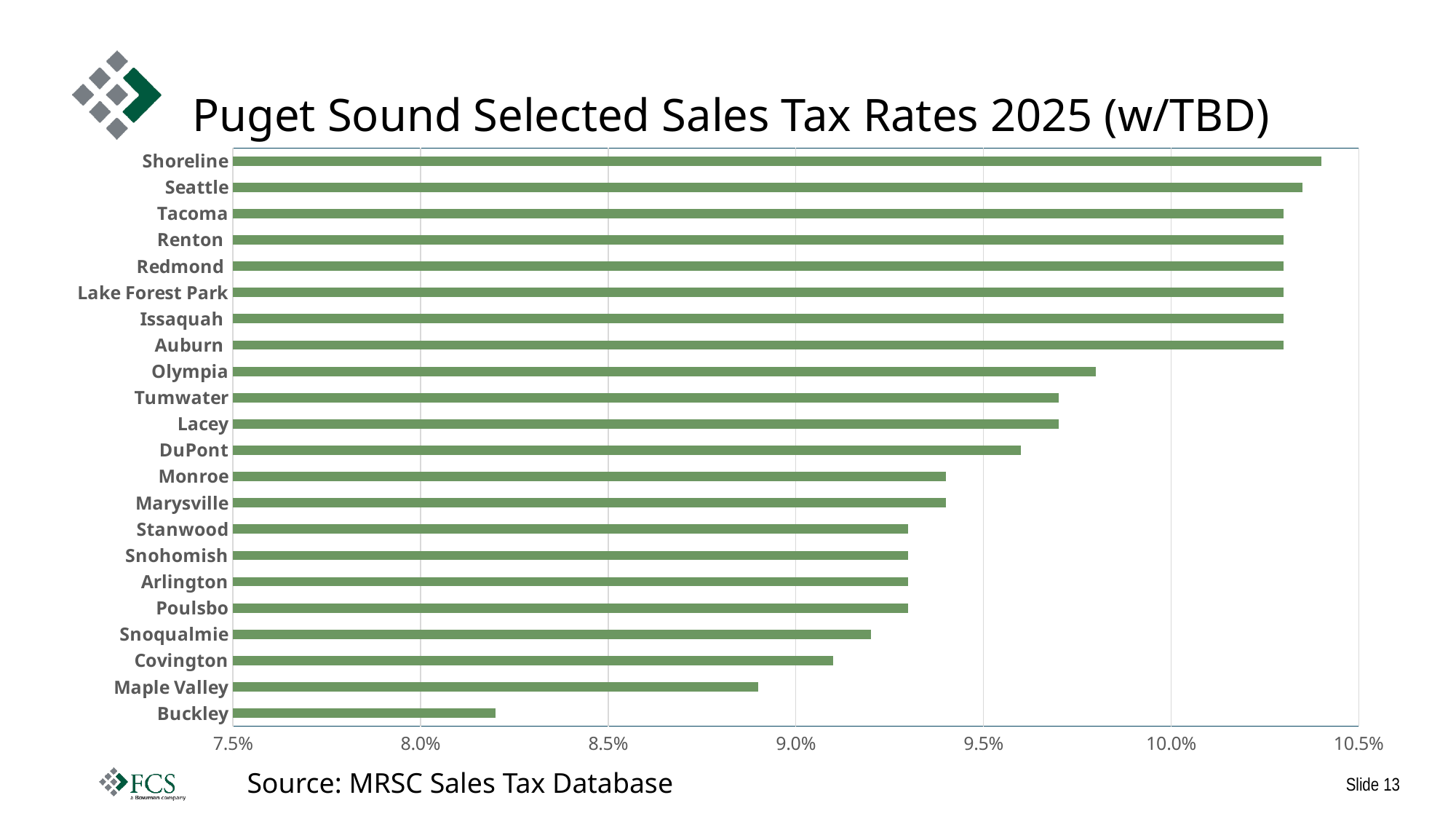
Which city has the highest sales tax rate in the chart? Shoreline Is the value for Olympia greater or less than 9.5%? greater What kind of chart is shown on the slide? Bar chart Which has the higher sales tax rate, Olympia or Tumwater? Olympia Is the value for Buckley greater or less than 8.5%? less Which has the higher sales tax rate, Covington or Maple Valley? Covington Is the value for Maple Valley greater or less than 9.0%? less What is the title of the chart? Puget Sound Selected Sales Tax Rates 2025 (w/TBD) Which city has the lowest sales tax rate in the chart? Buckley How many cities are listed in the chart? 22